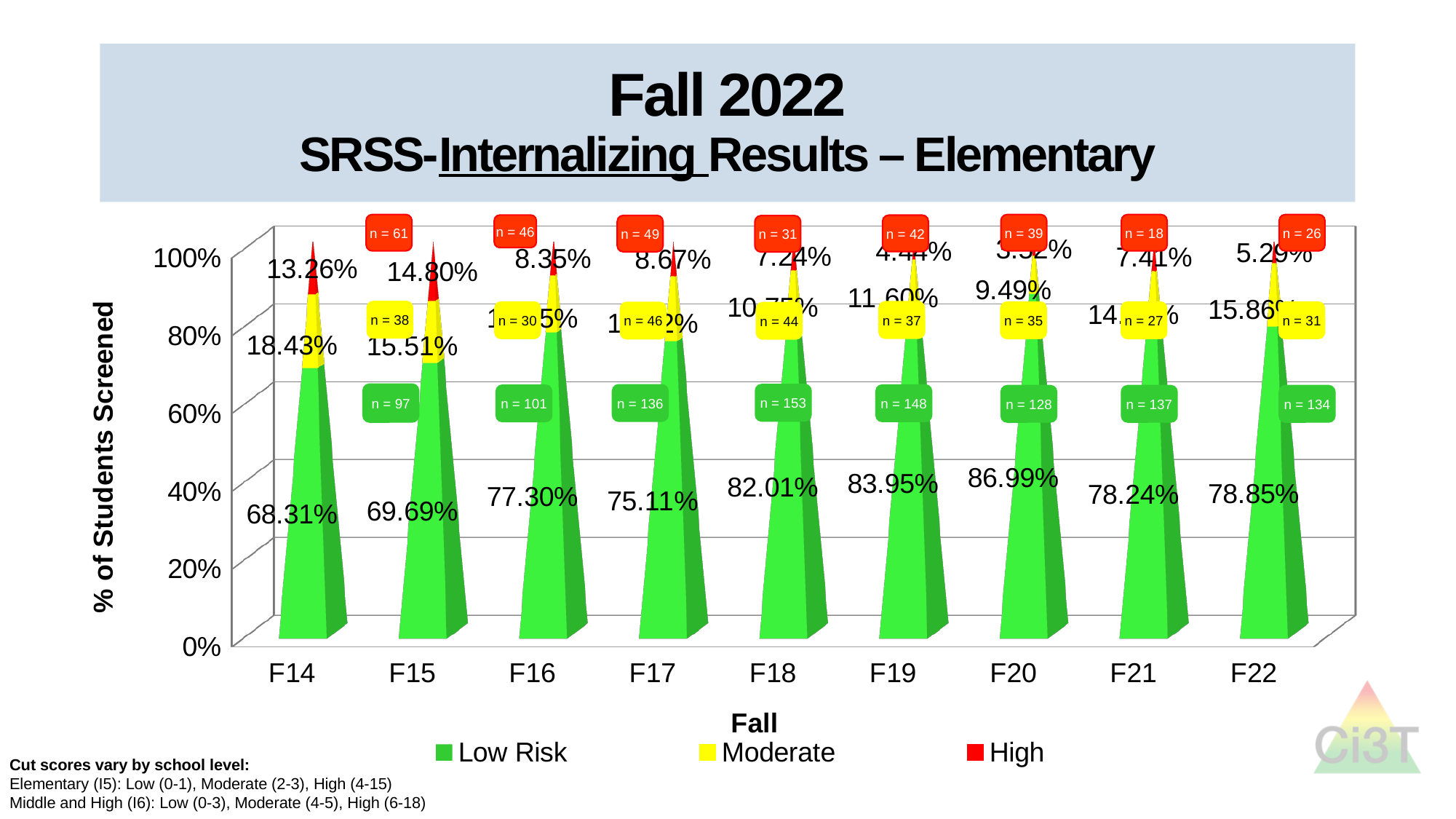
What is the difference between the High percentage for F15 and for F14? 1.54% Which fall has the highest Low Risk percentage? F20 Which fall has the lowest Low Risk percentage? F14 What is the High percentage for F15? 14.80% What is the Moderate percentage for F14? 18.43% What is the Low Risk percentage for F20? 86.99% What kind of chart is shown on the slide? Stacked bar chart What is the Low Risk percentage for F14? 68.31% Which has a larger Low Risk percentage, F17 or F18? F18 What is the n value shown for the Low Risk group in F18? n = 153 How many series does the legend list? 3 How many fall screening periods are shown on the x axis? 9